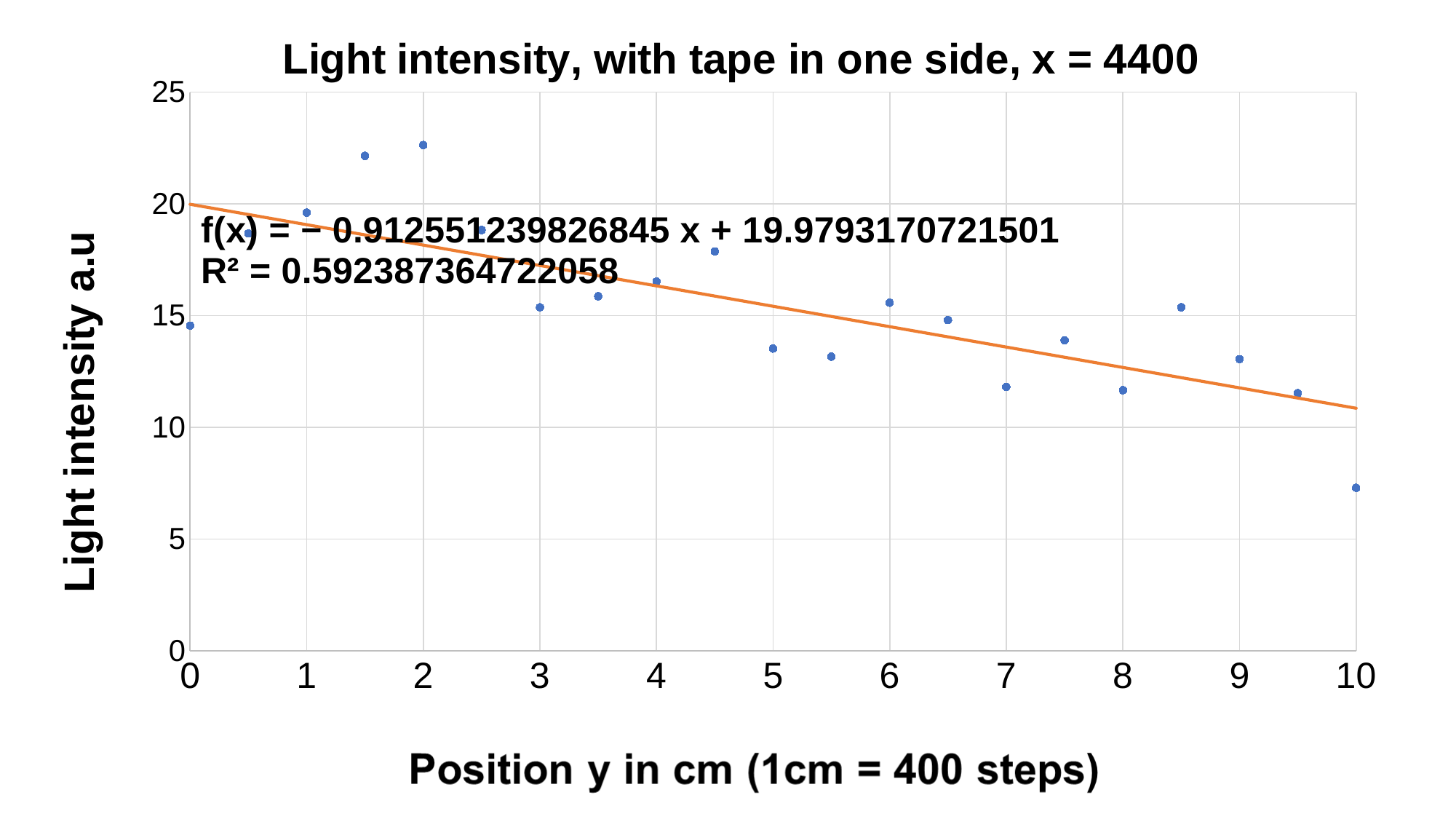
Is the light intensity at position y = 0 greater or less than 15? less Which has the higher light intensity: position y = 0 or position y = 1? Position y = 1 What is the R² value printed on the chart? 0.592387364722058 Is the light intensity at position y = 7 greater or less than 10? greater How many data points are plotted on the chart? 21 Is the light intensity at position y = 10 greater or less than 10? less Which has the higher light intensity: position y = 2 or position y = 10? Position y = 2 What kind of chart is shown on the slide? Scatter chart What is the title of the chart? Light intensity, with tape in one side, x = 4400 At which position y does the light intensity reach its lowest value? 10 Do the light intensity values generally rise or fall as position y increases? Fall